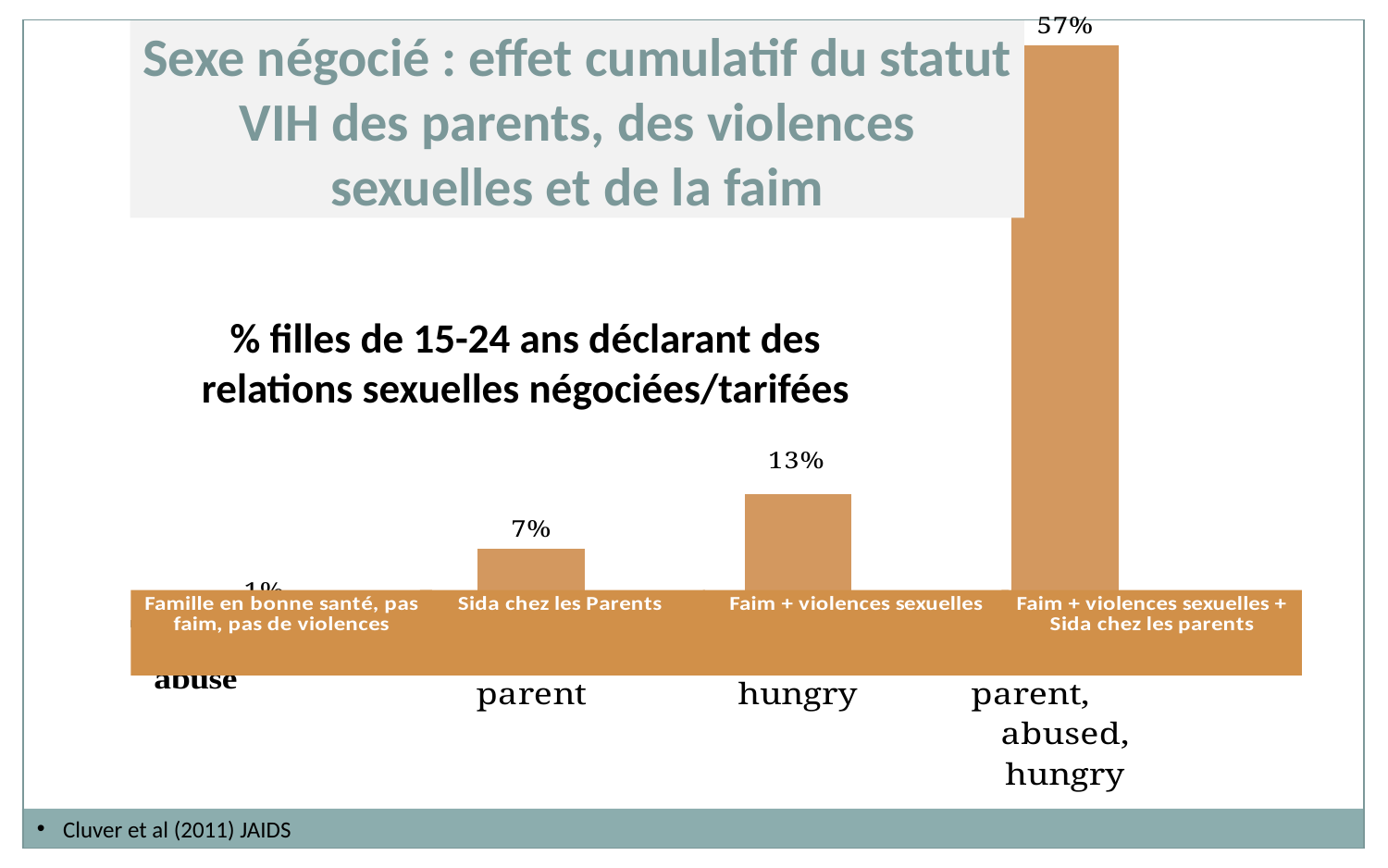
Which is larger: the value for 'Sida chez les Parents' or the value for 'Faim + violences sexuelles'? Faim + violences sexuelles How many categories are shown in the chart? 4 What is the difference between the 'Faim + violences sexuelles + Sida chez les parents' value and the 'Faim + violences sexuelles' value? 44% What value is shown for the 'Sida chez les Parents' bar? 7% What value is shown for the 'Faim + violences sexuelles' bar? 13% What kind of chart is shown on the slide? Bar chart What percentage is shown for the 'Faim + violences sexuelles + Sida chez les parents' category? 57% What is the difference between the 'Faim + violences sexuelles' value and the 'Sida chez les Parents' value? 6% Which category has the lowest value? Famille en bonne santé, pas faim, pas de violences Which category has the highest value? Faim + violences sexuelles + Sida chez les parents What is the title of the chart? % filles de 15-24 ans déclarant des relations sexuelles négociées/tarifées Do the values rise or fall from left to right across the categories? Rise